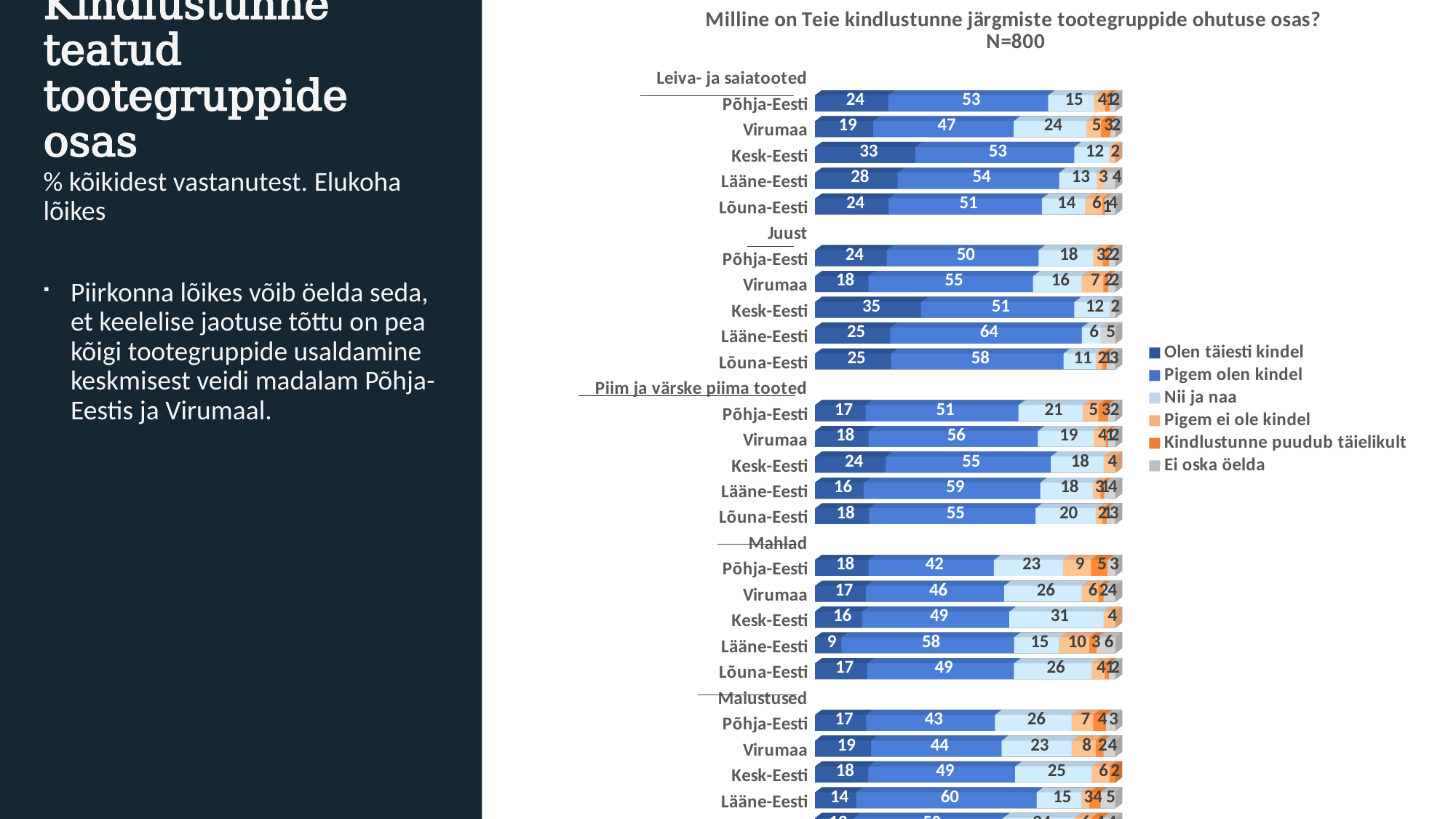
In the Juust group, what is the 'Pigem olen kindel' value for Lääne-Eesti? 64 In the Leiva- ja saiatooted group, which region has the highest 'Olen täiesti kindel' value? Kesk-Eesti In the Juust group, what is the 'Olen täiesti kindel' value for Kesk-Eesti? 35 In the Mahlad group, which region has the larger 'Pigem olen kindel' value, Lääne-Eesti or Põhja-Eesti? Lääne-Eesti In the Mahlad group, what is the 'Pigem ei ole kindel' value for Lääne-Eesti? 10 In the Maiustused group, what is the 'Pigem olen kindel' value for Lääne-Eesti? 60 What kind of chart is shown on the slide? Stacked bar chart What is the sample size (N) stated in the chart title? N=800 In the Mahlad group, which region has the lowest 'Olen täiesti kindel' value? Lääne-Eesti In the Juust group, what is the difference between the 'Olen täiesti kindel' values for Kesk-Eesti and Virumaa? 17 In the Mahlad group, what is the 'Nii ja naa' value for Kesk-Eesti? 31 How many series does the chart legend list? 6